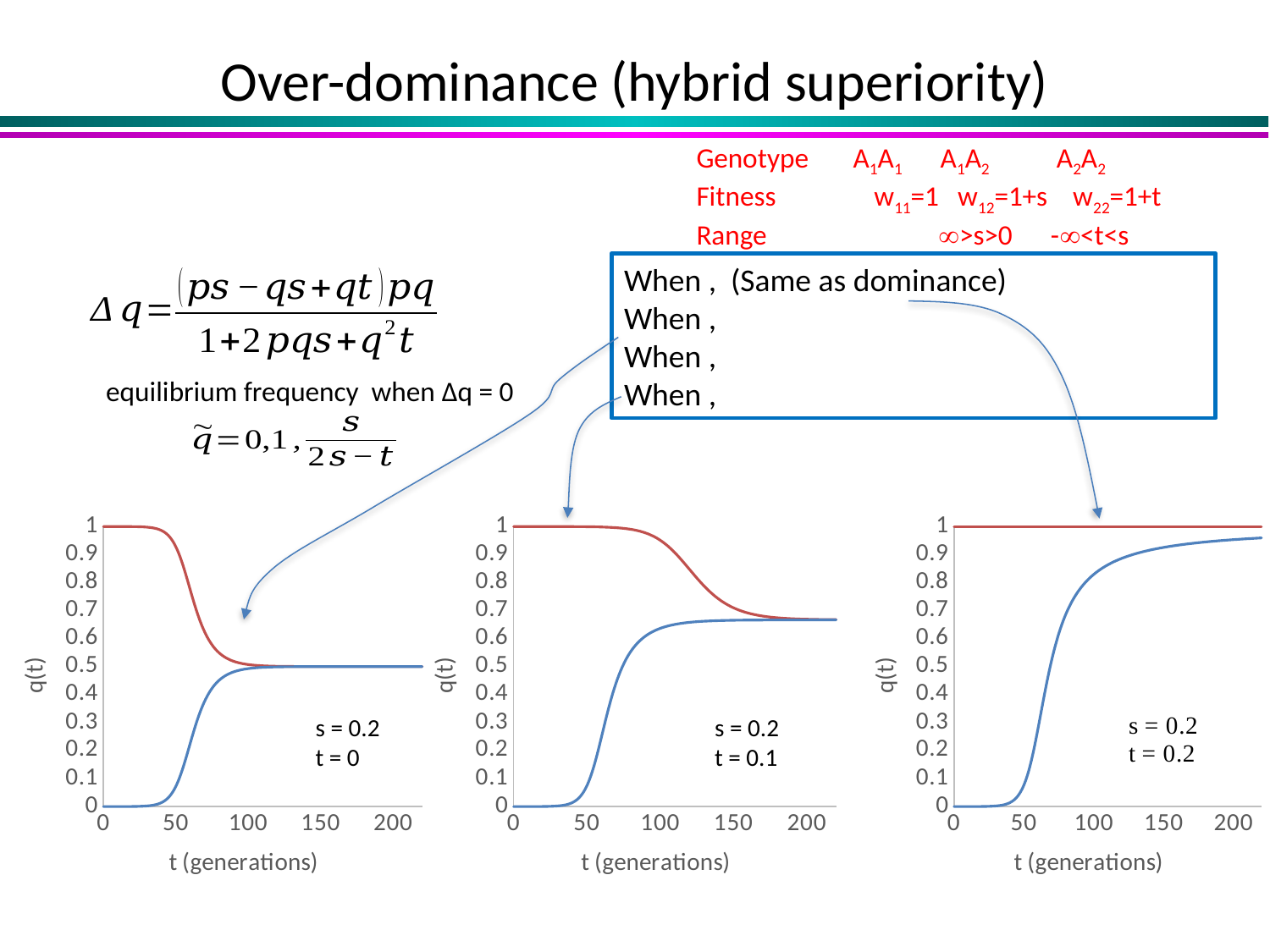
What kind of chart is the left chart (s = 0.2, t = 0)? line chart What is the x-axis label of the middle chart (s = 0.2, t = 0.1)? t (generations) In the middle chart (s = 0.2, t = 0.1), does the red line rise or fall as t increases? fall In the right chart (s = 0.2, t = 0.2), is the value of the blue line at t = 50 greater or less than 0.3? less In the left chart (s = 0.2, t = 0), is the value of the blue line at t = 200 greater or less than 0.4? greater In the left chart (s = 0.2, t = 0), does the blue line rise or fall as t increases? rise How many charts are shown on the slide? 3 In the left chart (s = 0.2, t = 0), is the value of the red line at t = 200 greater or less than 0.6? less In the left chart (s = 0.2, t = 0), how many lines are plotted? 2 What is the y-axis label of the right chart (s = 0.2, t = 0.2)? q(t)